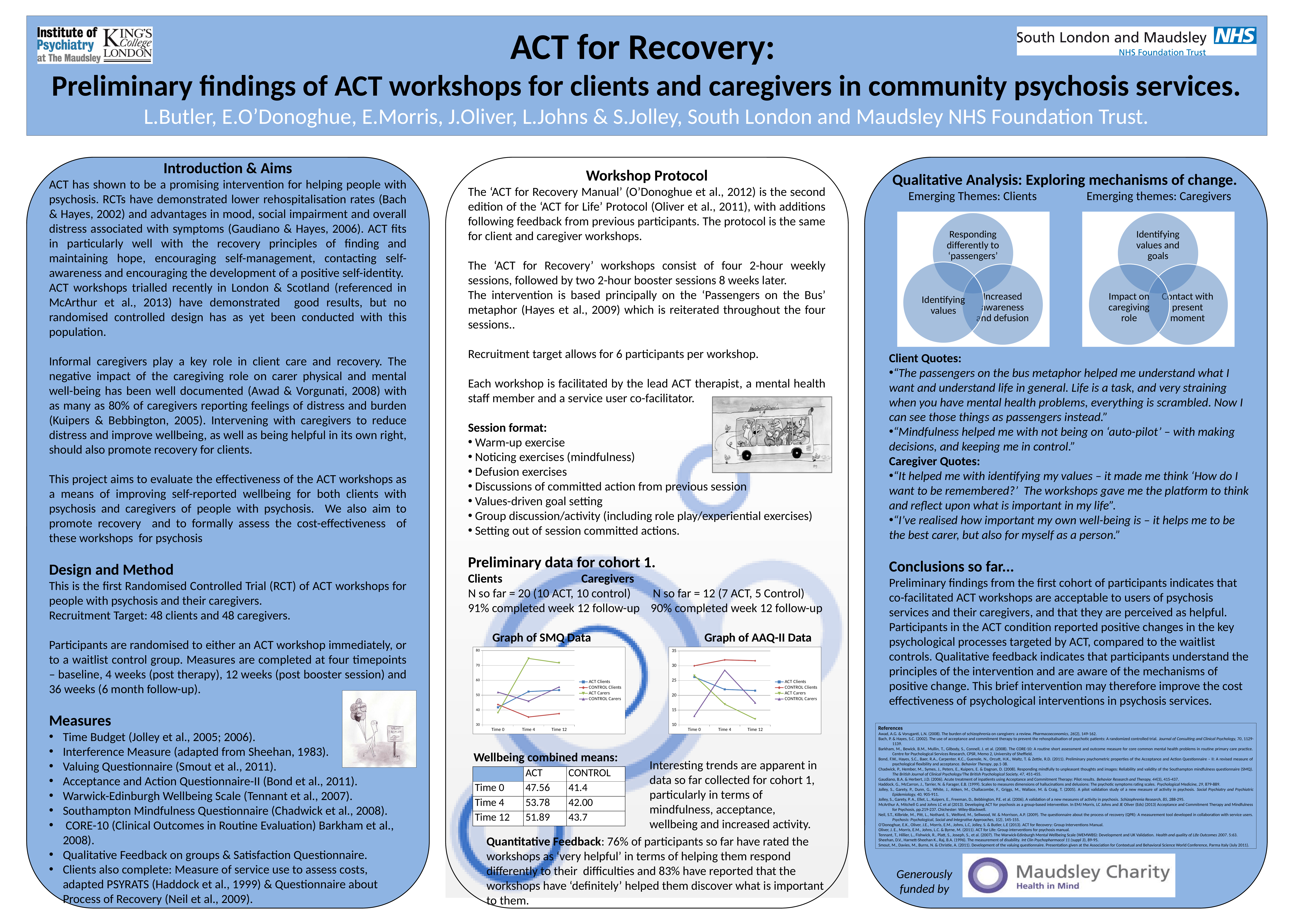
In the Graph of AAQ-II Data, is the value for ACT Carers at Time 12 greater or less than 15? less In the Graph of SMQ Data, which is larger at Time 12: ACT Clients or CONTROL Clients? ACT Clients In the Graph of AAQ-II Data, is the value for CONTROL Clients at Time 4 greater or less than 30? greater What are the x-axis labels on the Graph of AAQ-II Data? Time 0, Time 4, Time 12 In the Graph of SMQ Data, is the value for CONTROL Clients at Time 4 greater or less than 40? less In the Graph of AAQ-II Data, do the values for ACT Carers rise or fall from Time 0 to Time 12? fall How many series does the legend of the Graph of AAQ-II Data list? 4 In the Graph of AAQ-II Data, which series has the lowest value at Time 12? ACT Carers In the Graph of SMQ Data, which series has the highest value at Time 12? ACT Carers What kind of chart is the Graph of SMQ Data? line chart How many time points are plotted along the x axis of the Graph of SMQ Data? 3